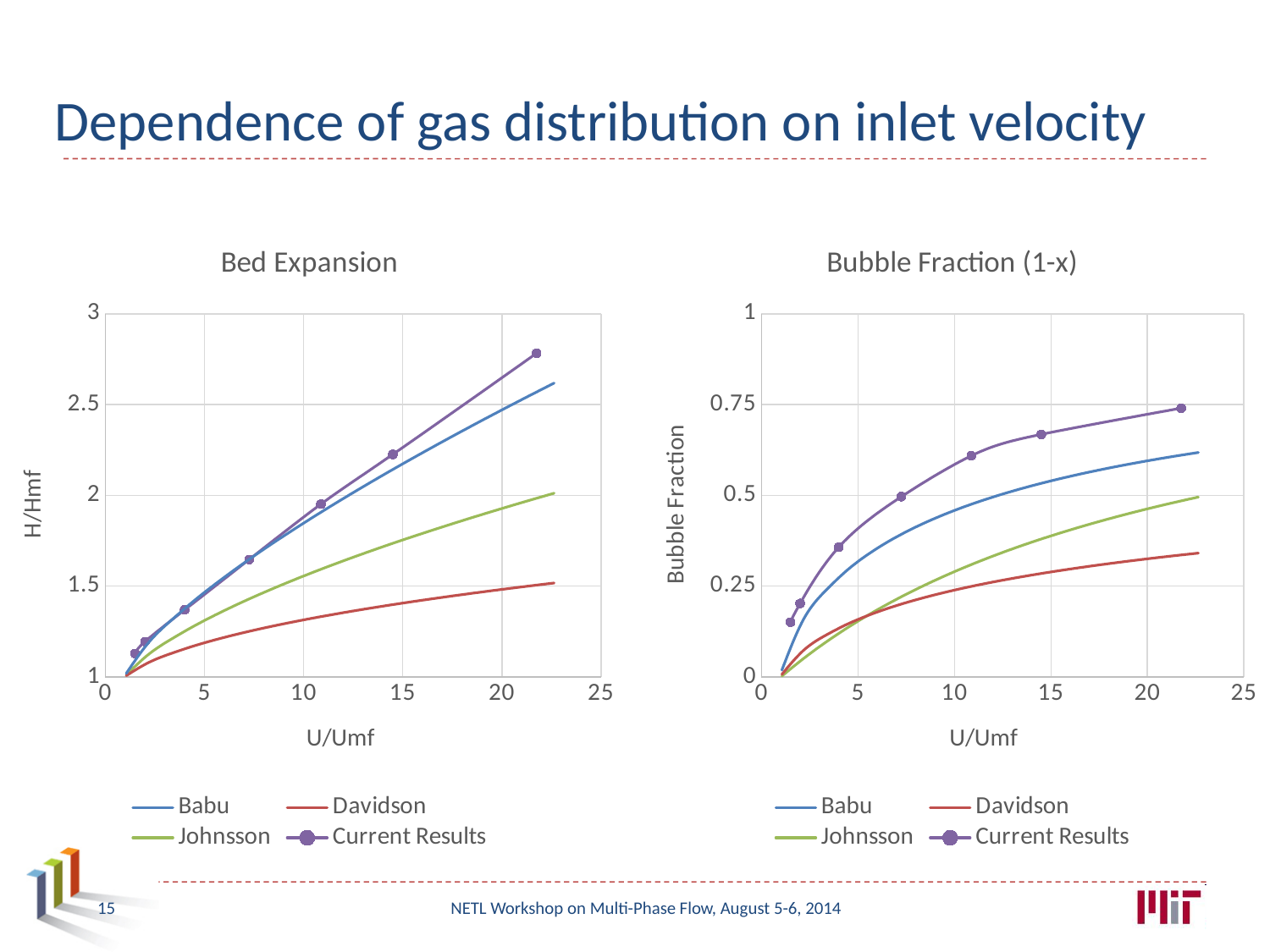
In the Bubble Fraction (1-x) chart, is the Babu value at the right end of the curve greater or less than 0.5? greater In the Bed Expansion chart, is the last Current Results value (at U/Umf of about 22) greater or less than 2.5? greater In the Bubble Fraction (1-x) chart, do the Current Results values rise or fall as U/Umf increases? rise What kind of chart is the Bed Expansion chart? line chart How many series does the legend of the Bubble Fraction (1-x) chart list? 4 In the Bubble Fraction (1-x) chart, which series has the lowest values at the right end of the x axis? Davidson In the Bubble Fraction (1-x) chart, how many marked data points does the Current Results series have? 7 In the Bed Expansion chart, how many marked data points does the Current Results series have? 7 In the Bed Expansion chart, at U/Umf = 20, which is larger, Babu or Johnsson? Babu In the Bed Expansion chart, which series reaches the highest H/Hmf value? Current Results In the Bubble Fraction (1-x) chart, is the Davidson value at the right end of the curve greater or less than 0.25? greater